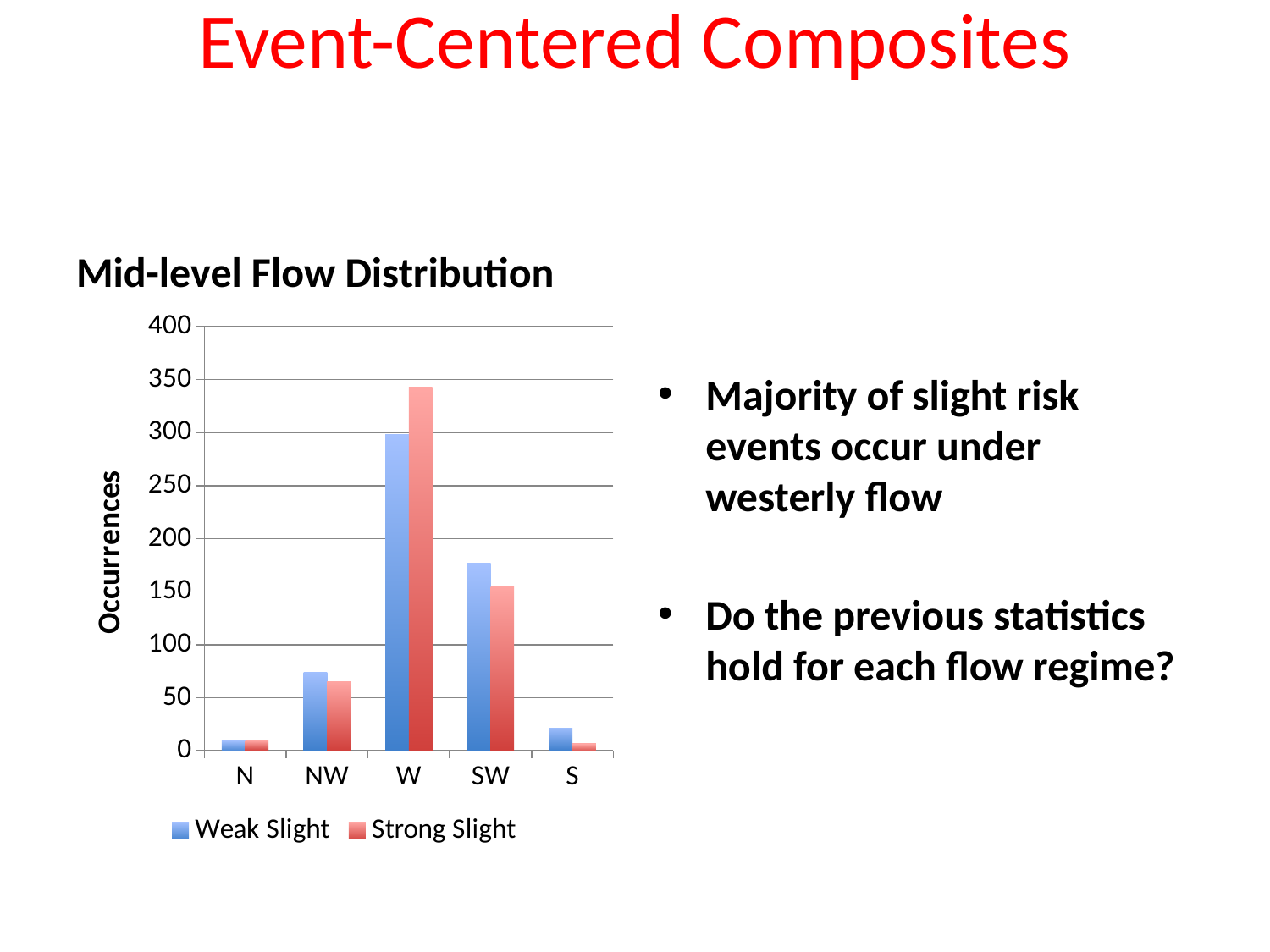
For the SW category, which series has more occurrences, Weak Slight or Strong Slight? Weak Slight Is the Weak Slight value for W greater or less than 250? greater What is the label on the y axis of the Mid-level Flow Distribution chart? Occurrences Which flow direction has the highest number of occurrences for the Weak Slight series? W Is the Strong Slight value for S greater or less than 50? less Which flow direction has the highest number of occurrences for the Strong Slight series? W How many series does the legend of the Mid-level Flow Distribution chart list? 2 For the W category, which series has more occurrences, Weak Slight or Strong Slight? Strong Slight What kind of chart is shown under the title "Mid-level Flow Distribution"? bar chart Which flow direction has the lowest number of occurrences for the Weak Slight series? N Is the Strong Slight value for W greater or less than 300? greater How many flow direction categories are shown on the x axis of the Mid-level Flow Distribution chart? 5